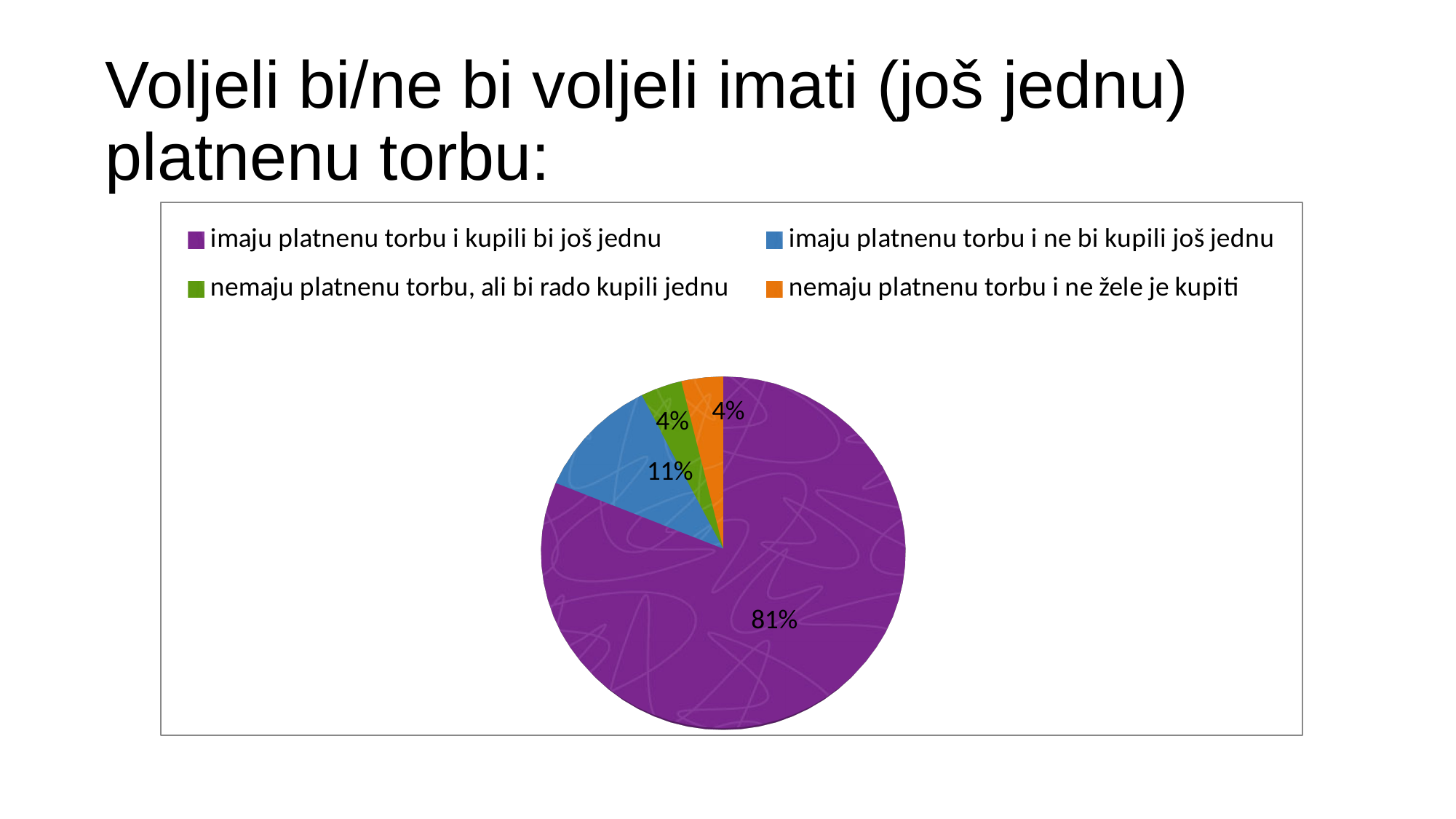
What is the combined share of the two "nemaju platnenu torbu" categories? 8% Which category has the largest slice of the pie? imaju platnenu torbu i kupili bi još jednu What is the difference in percentage points between "imaju platnenu torbu i kupili bi još jednu" and "imaju platnenu torbu i ne bi kupili još jednu"? 70 How many slices does the pie chart have? 4 What share of the pie is labelled for "nemaju platnenu torbu, ali bi rado kupili jednu"? 4% What kind of chart is shown on the slide? pie chart What share of the pie is labelled for "imaju platnenu torbu i kupili bi još jednu"? 81% What share of the pie is labelled for "nemaju platnenu torbu i ne žele je kupiti"? 4% Which is larger: the slice for "imaju platnenu torbu i ne bi kupili još jednu" or the slice for "nemaju platnenu torbu i ne žele je kupiti"? imaju platnenu torbu i ne bi kupili još jednu What share of the pie is labelled for "imaju platnenu torbu i ne bi kupili još jednu"? 11% How many entries does the legend list? 4 What colour is the slice for "nemaju platnenu torbu i ne žele je kupiti"? orange